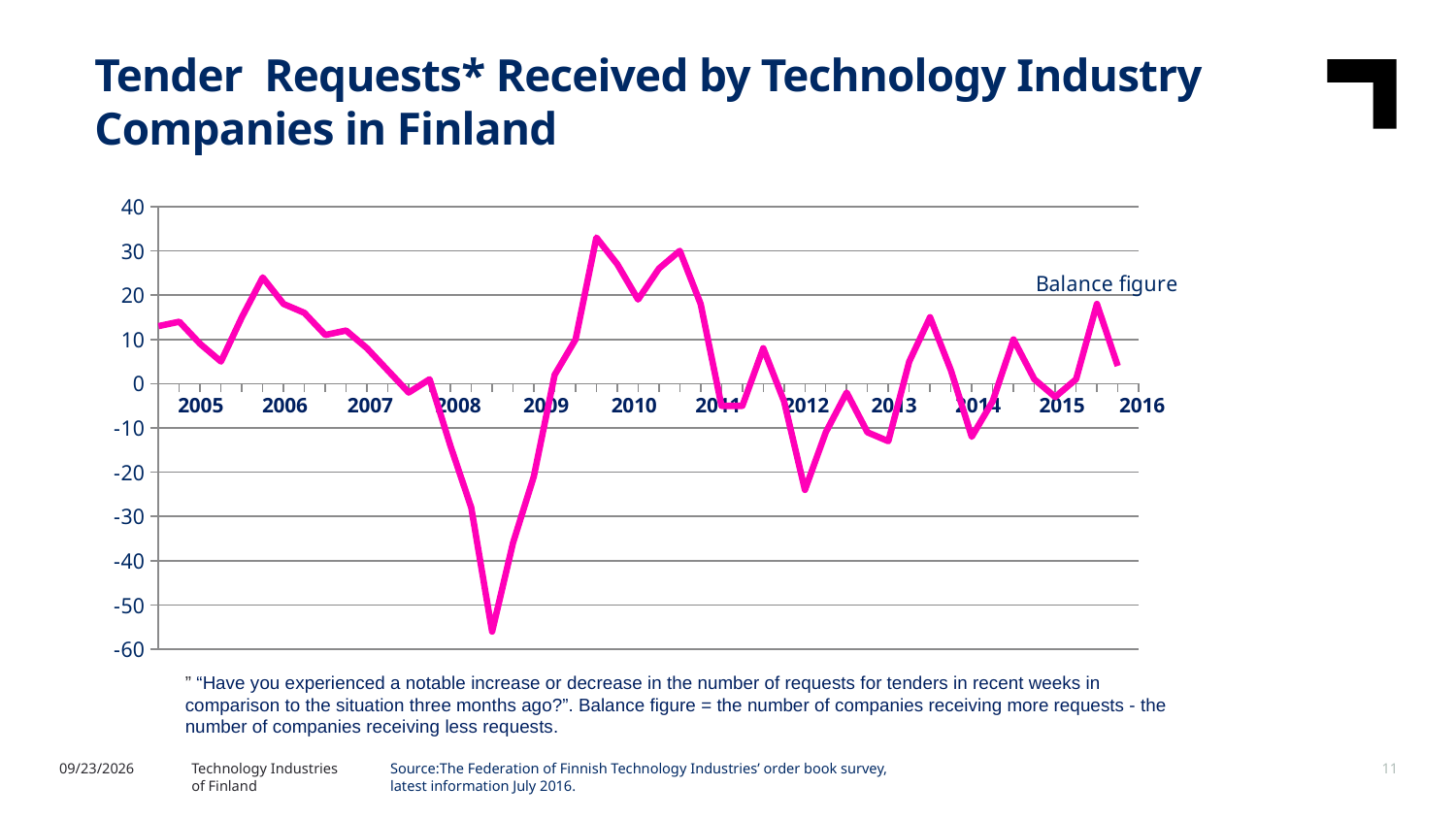
What kind of chart is shown on the slide? line chart Is the lowest value of the balance figure greater or less than -50? less How many series does the chart show? 1 Is the balance figure at the start of 2005 greater or less than 10? greater Does the balance figure rise or fall between 2007 and 2008? fall What colour is the line on the chart? pink Is the lowest value of the balance figure in 2012 greater or less than -20? less What is the name of the series plotted on the chart? Balance figure In which year does the balance figure reach its lowest point? 2009 How many year labels are shown on the x axis? 12